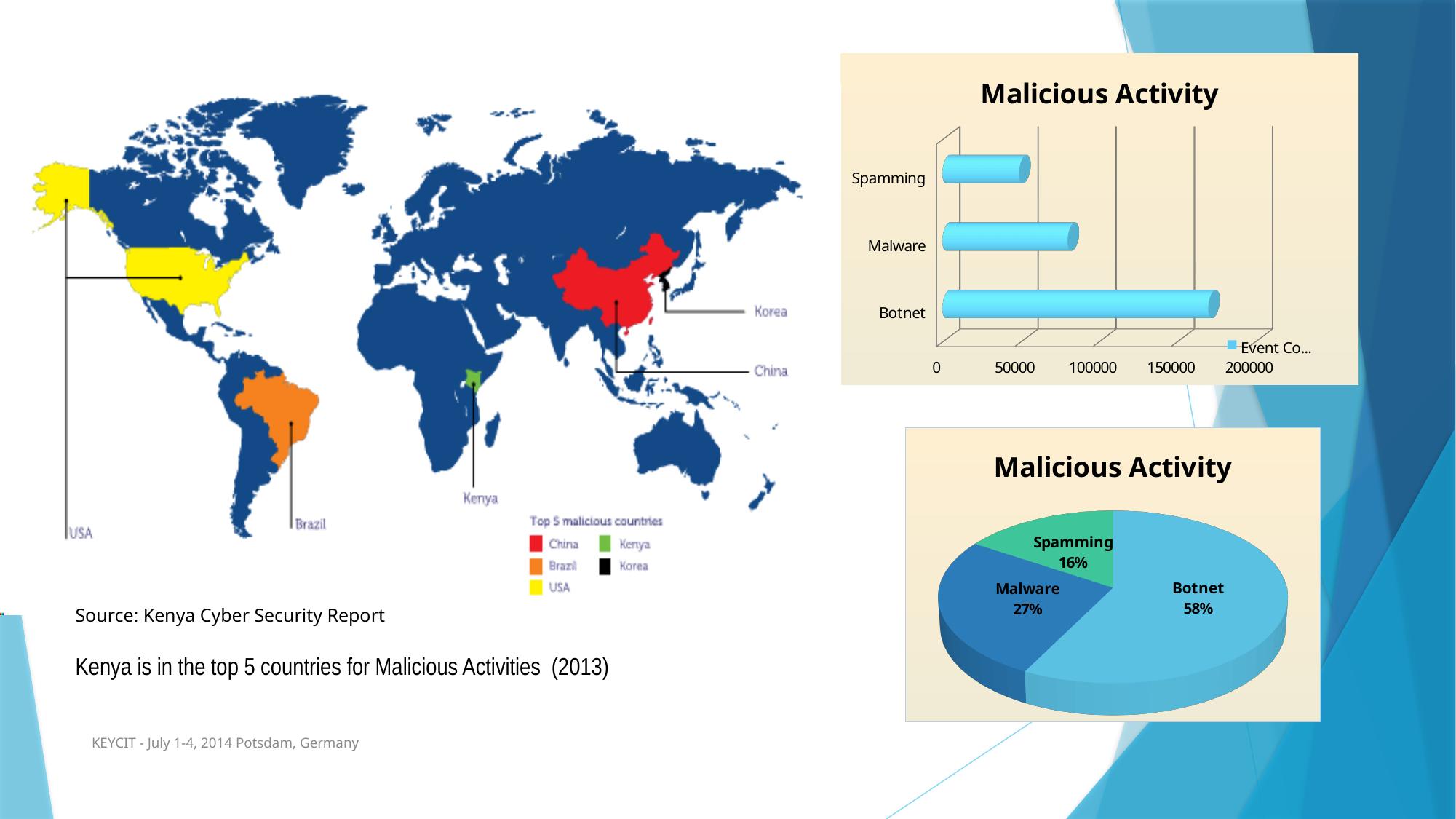
In the bar chart at the top right, which category has the highest value? Botnet In the bar chart at the top right, which category has the lowest value? Spamming In the pie chart at the bottom right, what percentage share does Spamming have? 16% What kind of chart is the top-right chart titled Malicious Activity? bar chart In the pie chart at the bottom right, how many percentage points larger is the Botnet share than the Malware share? 31% In the pie chart at the bottom right, which category has the smallest slice? Spamming In the bar chart at the top right, is the value for Malware greater or less than 100000? less In the pie chart at the bottom right, which category has the largest slice? Botnet In the pie chart at the bottom right, what percentage share does Botnet have? 58% How many categories are shown in the bar chart at the top right? 3 In the bar chart at the top right, is the value for Botnet greater or less than 150000? greater In the pie chart at the bottom right, what percentage share does Malware have? 27%